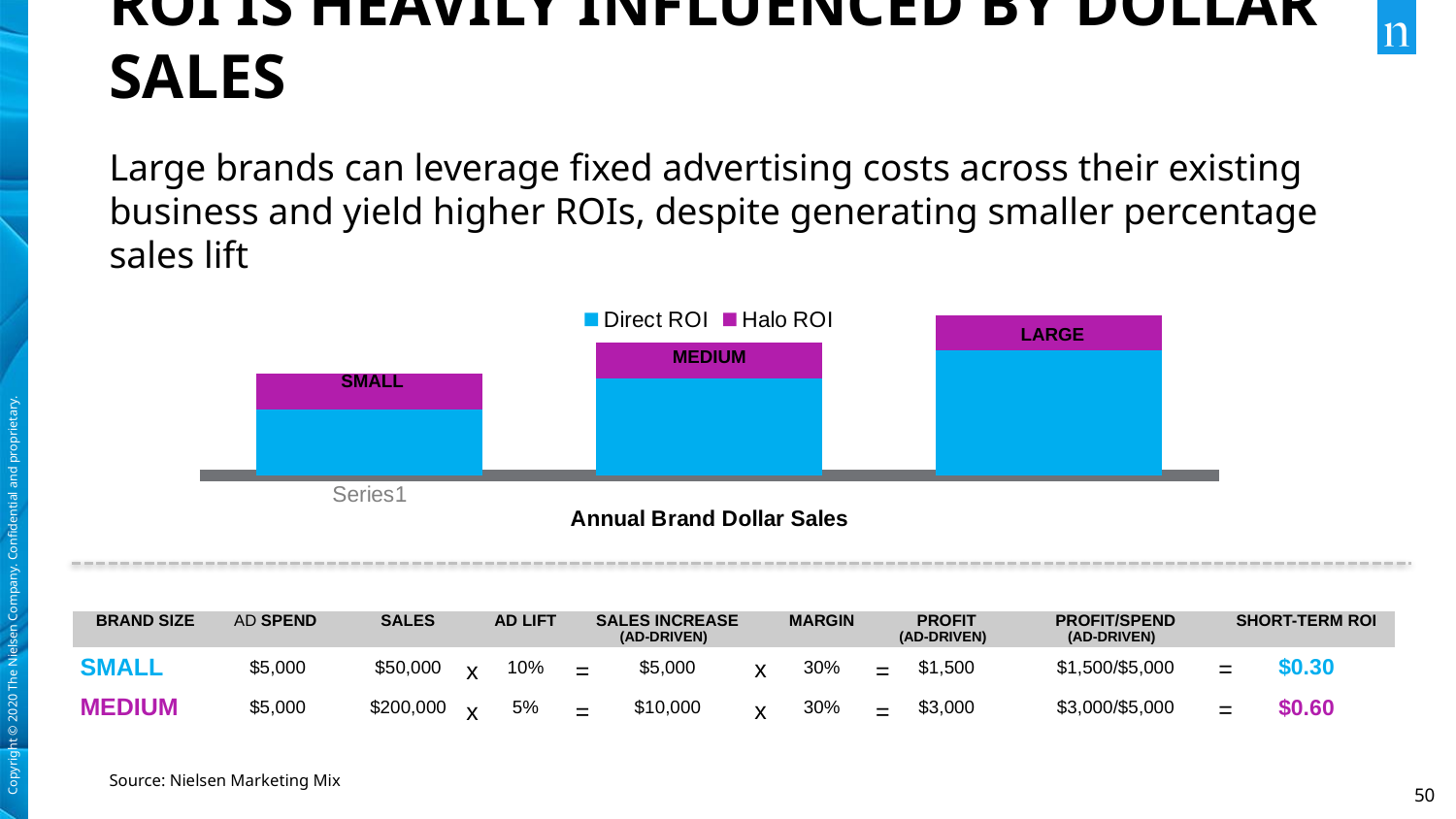
How many brand-size bars are plotted in the chart? 3 What is the label shown beneath the x axis of the chart? Annual Brand Dollar Sales Which brand size has the shortest stacked bar in the chart? SMALL Is the total bar for MEDIUM taller or shorter than the total bar for SMALL? taller What are the two series named in the chart legend? Direct ROI and Halo ROI Is the total bar for LARGE taller or shorter than the total bar for MEDIUM? taller Which series is shown in blue in the chart? Direct ROI How many series does the chart legend list? 2 Which brand size has the tallest stacked bar in the chart? LARGE What kind of chart is shown on the slide? stacked bar chart Do the stacked bar heights rise or fall moving from SMALL to LARGE along the x axis? rise